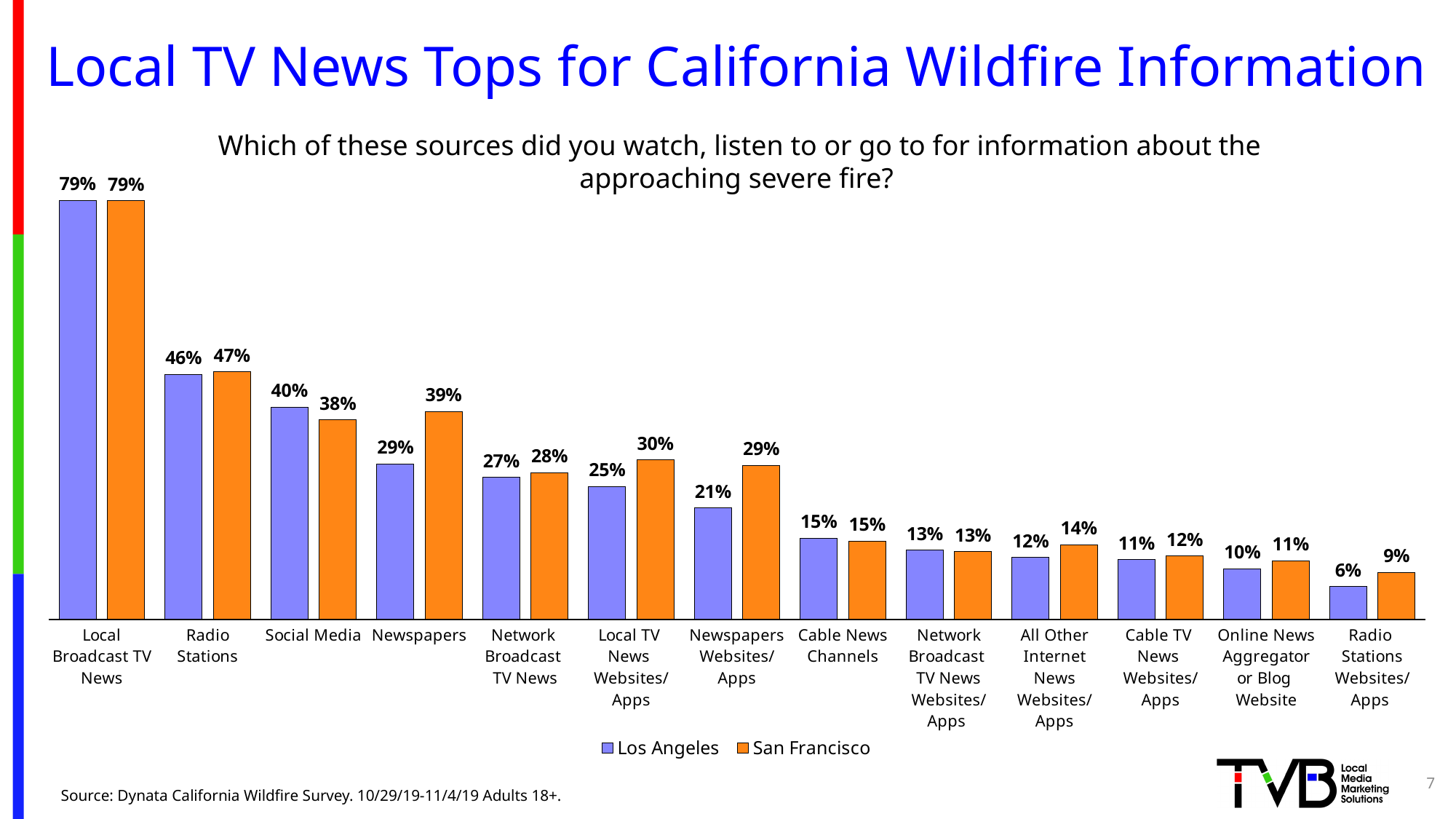
Which source has the lowest Los Angeles value? Radio Stations Websites/Apps What is the Los Angeles value for Newspapers Websites/Apps? 21% For Social Media, which city has the larger value, Los Angeles or San Francisco? Los Angeles What is the San Francisco value for Newspapers? 39% What is the difference between the San Francisco and Los Angeles values for Newspapers? 10% What is the difference between the Los Angeles values for Radio Stations and Social Media? 6% Which source has the highest San Francisco value? Local Broadcast TV News What percentage of Los Angeles respondents used Local Broadcast TV News for information about the approaching fire? 79% What kind of chart is shown on the slide? Bar chart How many series does the legend list? 2 How many sources are shown on the x axis? 13 Which colour represents San Francisco in the chart? Orange